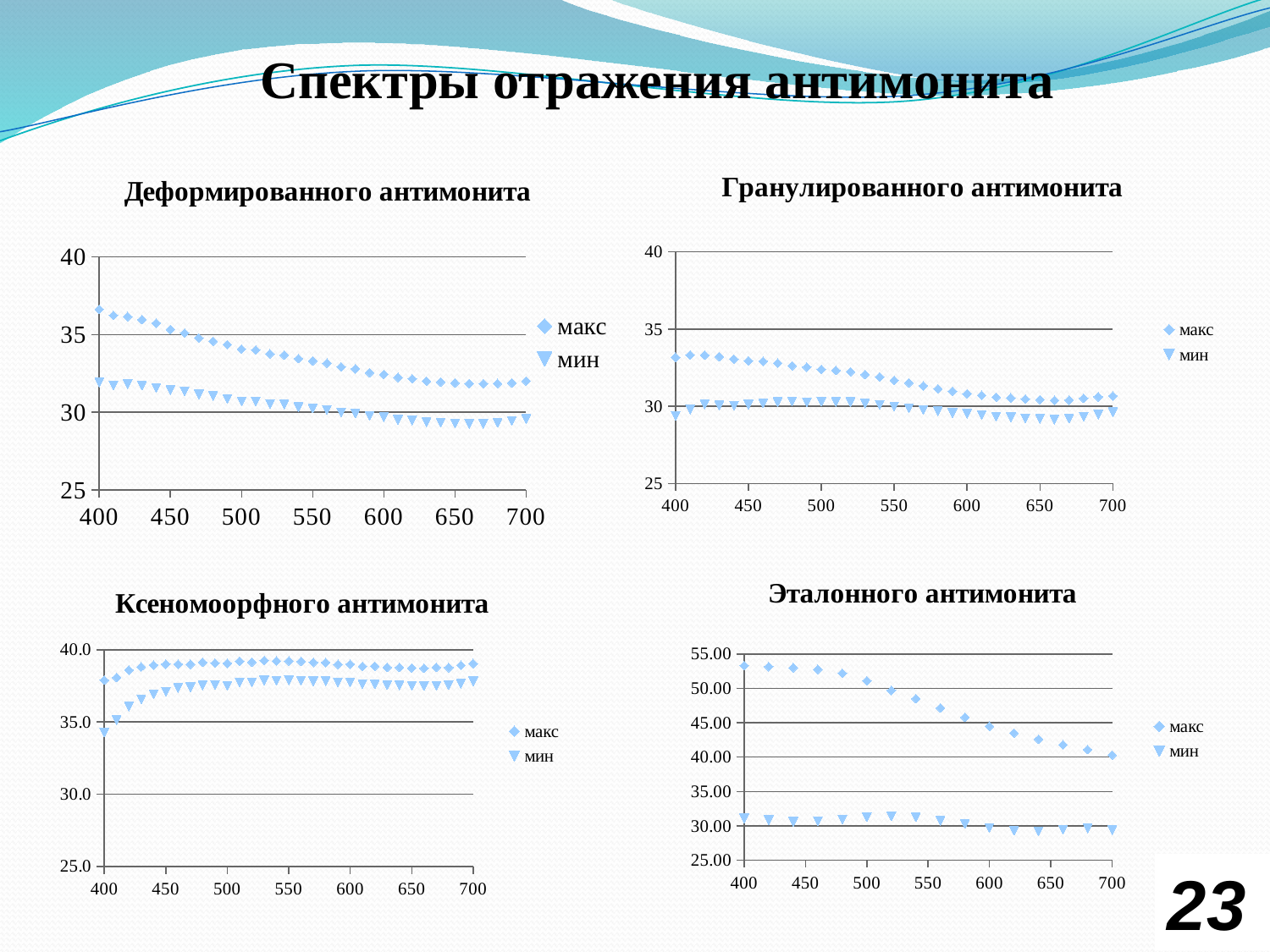
In the 'Эталонного антимонита' chart, which series has the larger value at 400, 'макс' or 'мин'? макс In the 'Деформированного антимонита' chart, is the 'макс' value at 400 greater or less than 35? greater In the 'Ксеномоорфного антимонита' chart, is the 'макс' value at 700 greater or less than 35.0? greater What kind of chart is the 'Деформированного антимонита' chart? scatter chart In the 'Эталонного антимонита' chart, does the 'макс' series rise or fall from 400 to 700? fall In the 'Эталонного антимонита' chart, is the 'макс' value at 400 greater or less than 50.00? greater What is the title of the slide containing the four charts? Спектры отражения антимонита How many series does the legend of the 'Деформированного антимонита' chart list? 2 What are the two legend entries in the 'Гранулированного антимонита' chart? макс and мин In the 'Деформированного антимонита' chart, does the 'макс' series rise or fall from 400 to 700? fall